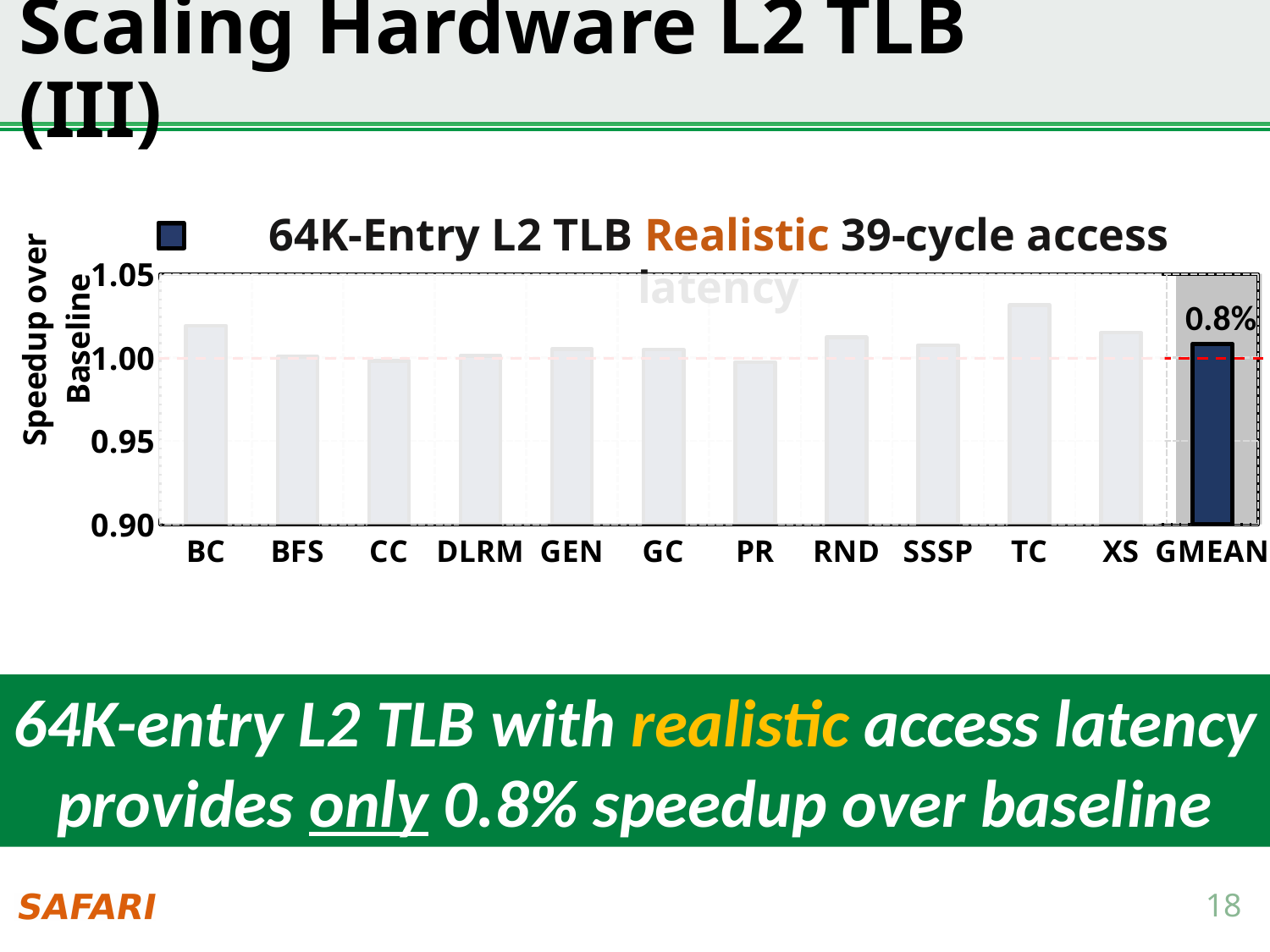
Which is larger, the value for BC or the value for BFS? BC What kind of chart is shown on the slide? bar chart Is the value for BC greater or less than 1.00? greater What is the label of the chart's y axis? Speedup over Baseline What speedup label is printed above the GMEAN bar? 0.8% Which category has the highest speedup over baseline? TC Which is larger, the value for TC or the value for BC? TC Is the value for TC greater or less than 1.05? less How many categories are shown on the x axis of the chart? 12 What is the legend entry of the chart? 64K-Entry L2 TLB Realistic 39-cycle access latency How many series does the chart's legend list? 1 Is the value for XS greater or less than 1.00? greater